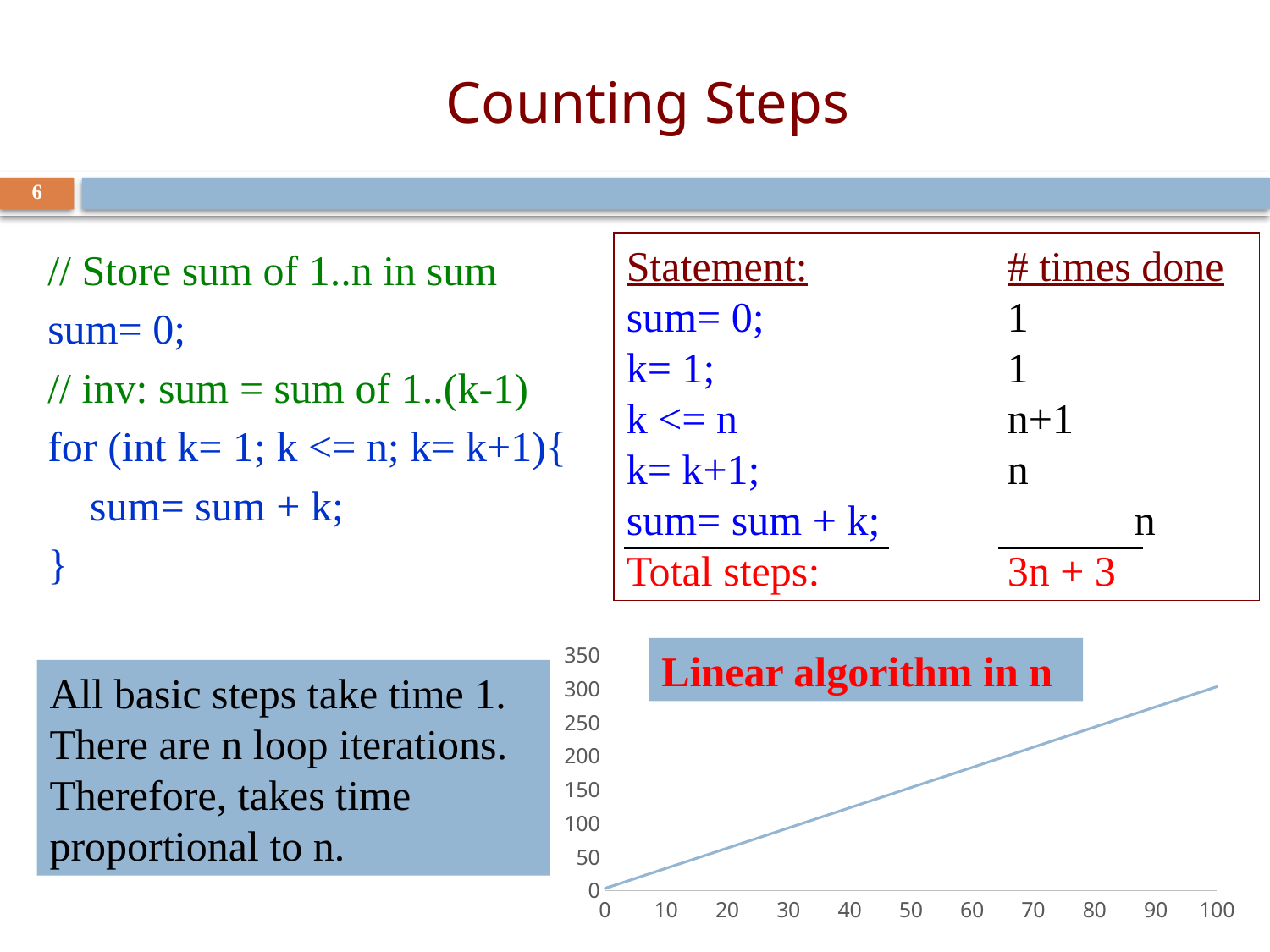
In the chart at the bottom right, is the value at x = 40 greater or less than 150? less In the chart at the bottom right, is the value at x = 10 greater or less than 50? less In the chart at the bottom right, is the value at x = 50 greater or less than 100? greater What kind of chart is shown at the bottom right of the slide? line chart How many lines are plotted in the chart at the bottom right of the slide? 1 In the chart at the bottom right, do the values rise or fall as the x axis increases from 0 to 100? rise What is the highest tick value shown on the x axis of the chart at the bottom right? 100 What is the highest tick value shown on the y axis of the chart at the bottom right? 350